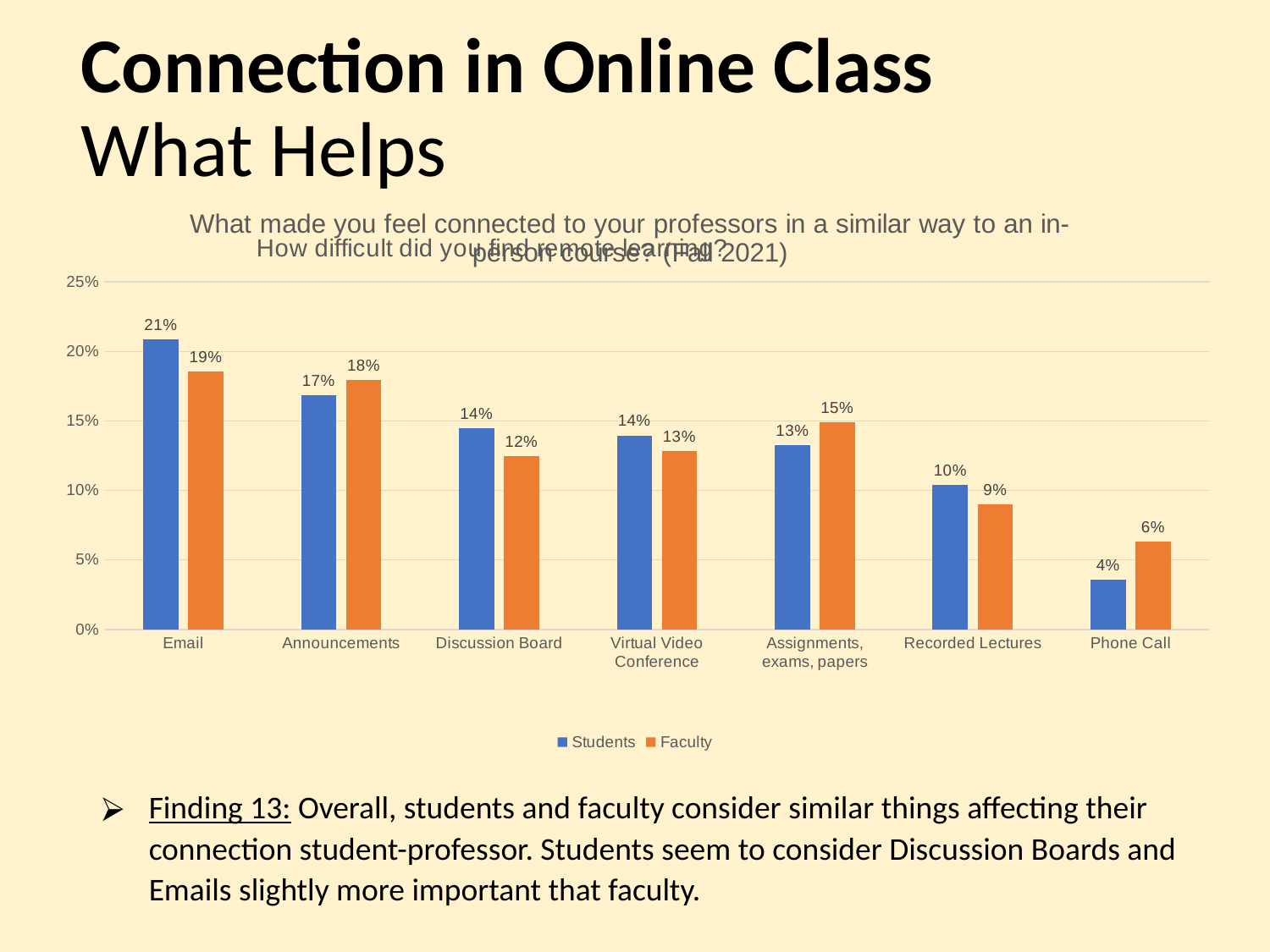
Which category has the lowest Faculty value? Phone Call Which colour represents the Faculty series in the chart? orange How many categories are shown on the x axis? 7 What is the difference between the Students and Faculty values for Discussion Board? 2% Is the Students value for Recorded Lectures greater or less than 5%? greater What kind of chart is shown on the slide? bar chart How many series does the legend list? 2 Which is larger for Announcements, the Students value or the Faculty value? Faculty What is the Faculty value for Assignments, exams, papers? 15% What is the Faculty value for Phone Call? 6% What is the Students value for Email? 21% Which category has the highest Students value? Email